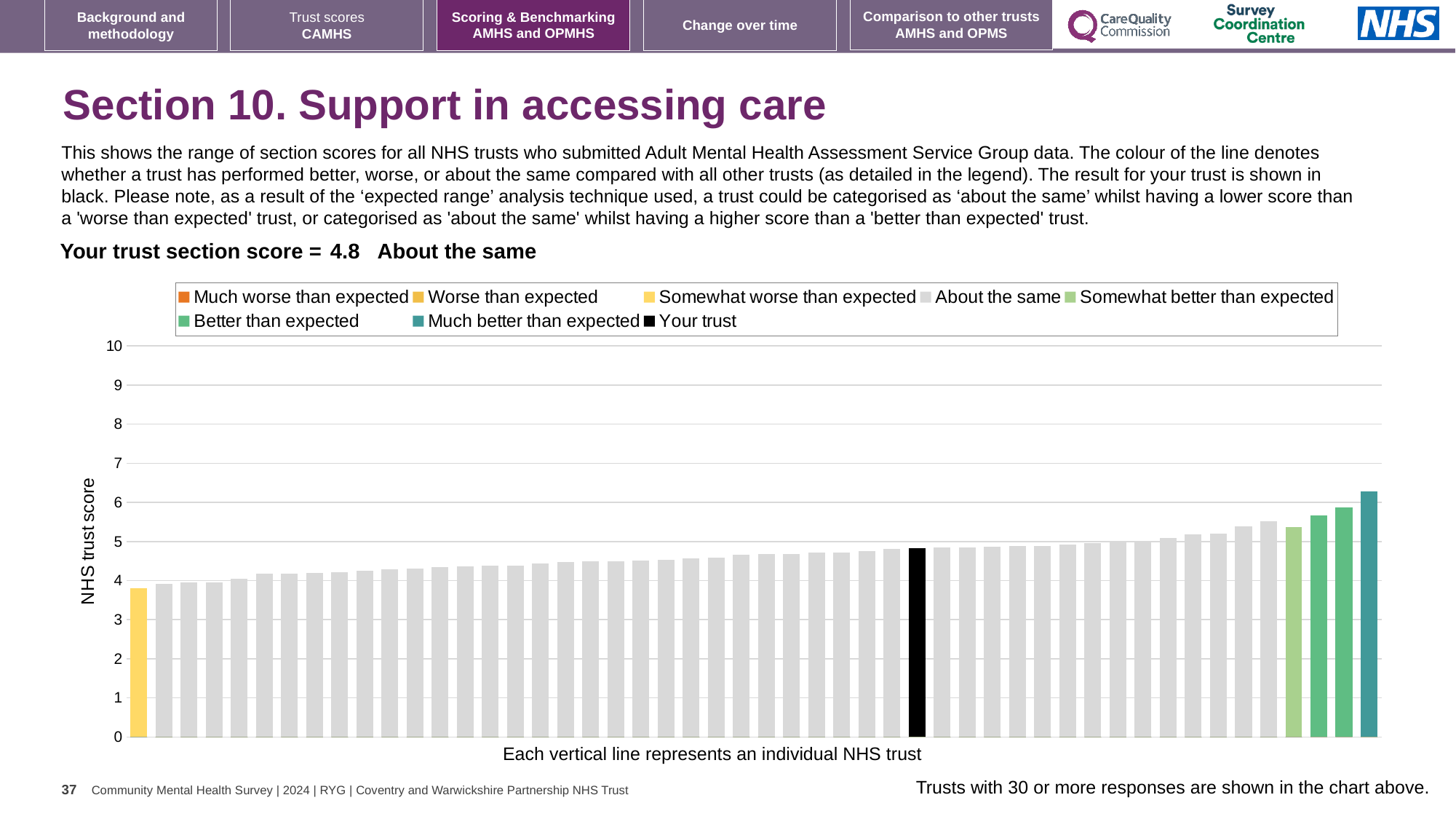
Which is taller, the leftmost bar or the rightmost bar? The rightmost bar What is the label on the vertical axis of the chart? NHS trust score Which legend category does the tallest bar belong to? Much better than expected What kind of chart is shown on the slide? Bar chart What is the section score for your trust shown on the slide? 4.8 Which performance category is your trust placed in for this section? About the same How many entries does the chart legend list? 8 Is the value of the black 'Your trust' bar greater or less than 5? less Do the bar values rise or fall from left to right along the x axis? Rise Is the value of the tallest bar (the teal bar on the far right) greater or less than 6? greater How many bars are coloured in the 'Better than expected' green? 2 Is the value of the leftmost yellow bar greater or less than 3? greater